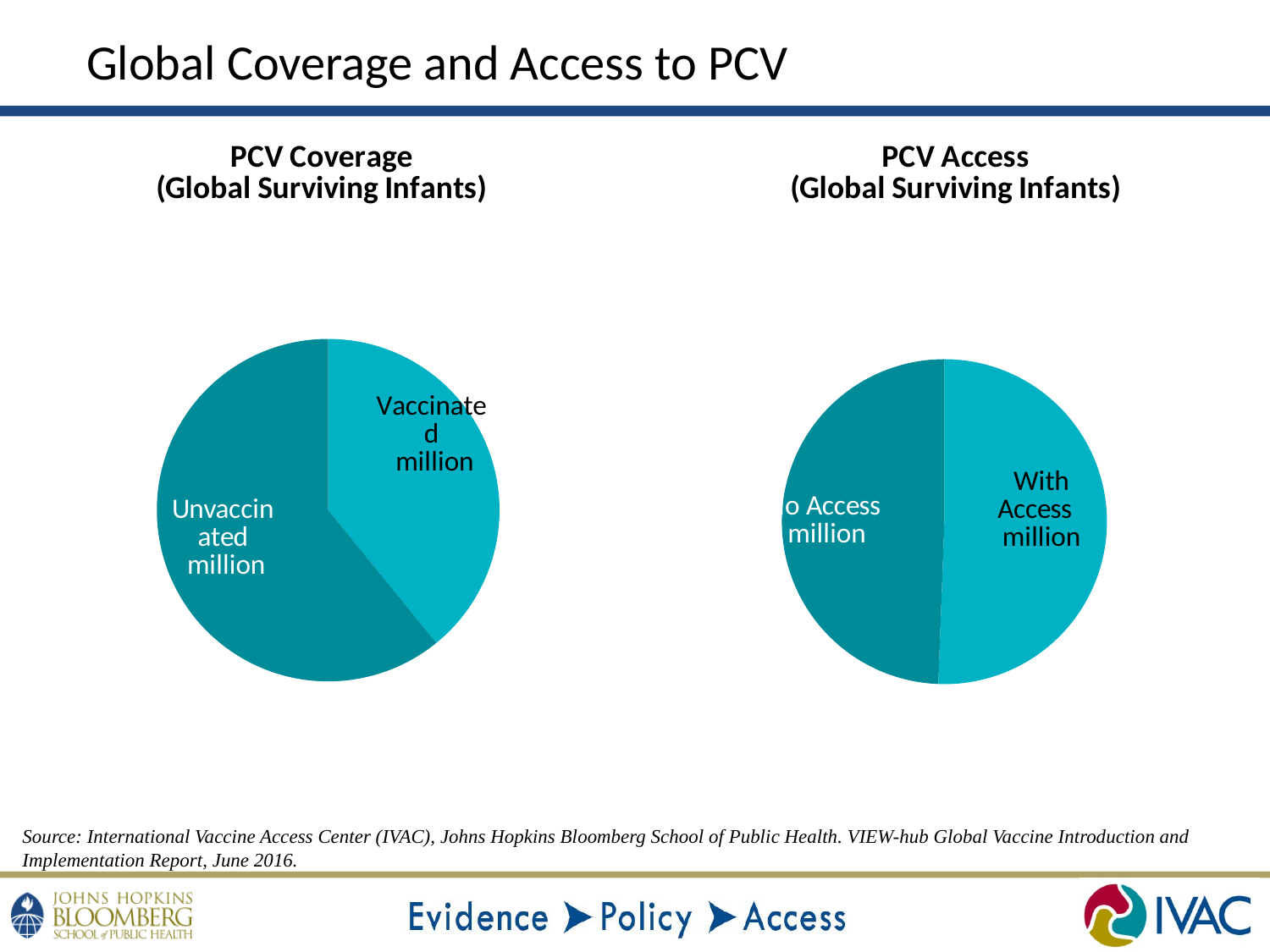
What kind of chart is the PCV Coverage (Global Surviving Infants) chart on the left? pie chart In the PCV Coverage (Global Surviving Infants) chart, which slice is the largest? Unvaccinated In the PCV Coverage (Global Surviving Infants) chart, which slice is the smallest? Vaccinated In the PCV Coverage (Global Surviving Infants) chart, does the Unvaccinated slice take up more or less than half of the pie? more What is the title of the chart on the left of the slide? PCV Coverage (Global Surviving Infants) In the PCV Coverage (Global Surviving Infants) chart, how many slices does the pie have? 2 What is the title of the chart on the right of the slide? PCV Access (Global Surviving Infants) In the PCV Access (Global Surviving Infants) chart, how many slices does the pie have? 2 What kind of chart is the PCV Access (Global Surviving Infants) chart on the right? pie chart How many charts are shown on the slide? 2 In the PCV Coverage (Global Surviving Infants) chart, which slice is larger, Vaccinated or Unvaccinated? Unvaccinated